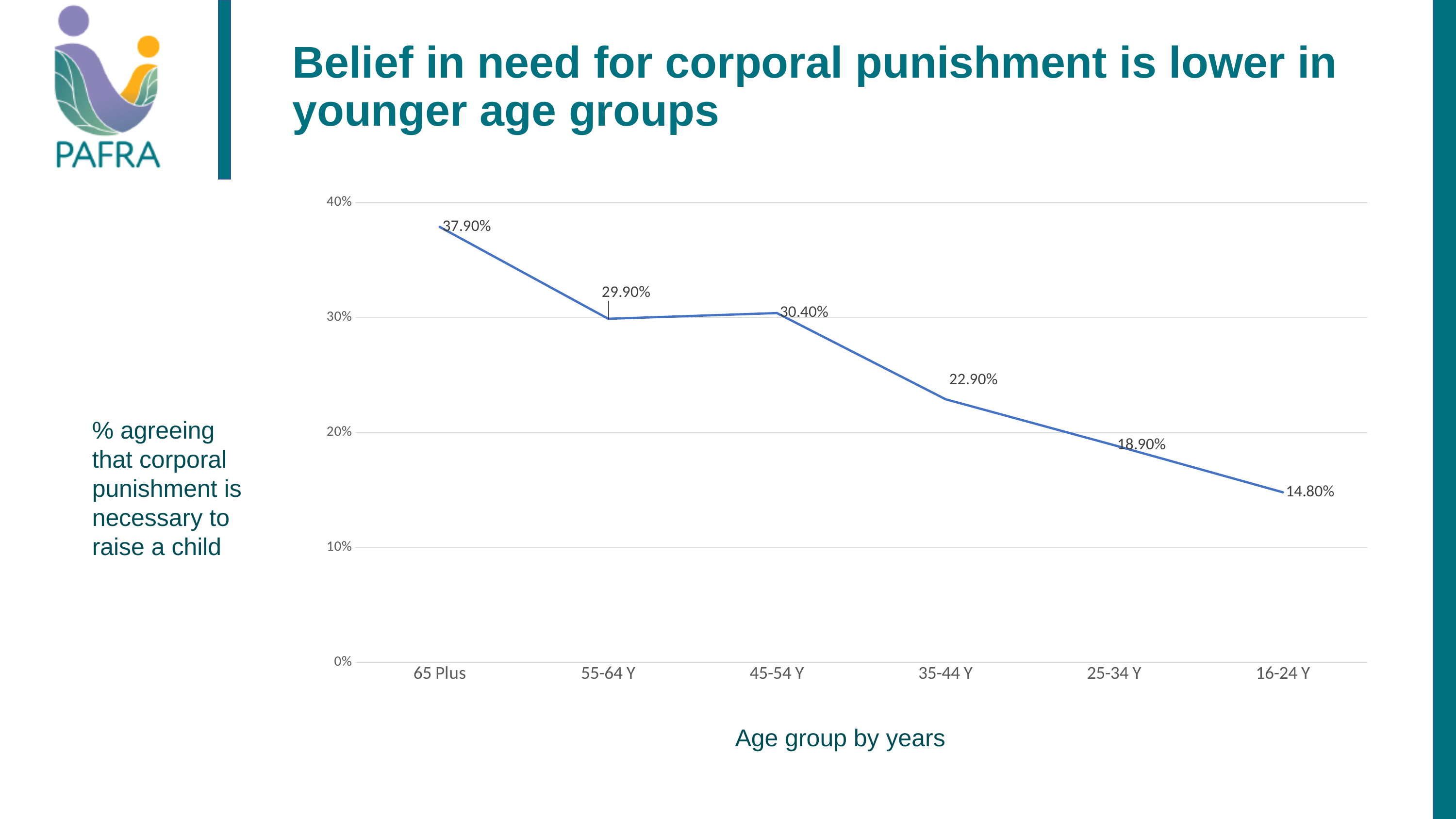
What is the value shown for the 16-24 Y age group? 14.80% How many age groups are plotted on the chart? 6 What percentage of the 65 Plus age group agrees that corporal punishment is necessary to raise a child? 37.90% What is the value shown for the 45-54 Y age group? 30.40% What is the difference between the values for 65 Plus and 16-24 Y? 23.10% Which age group has the highest percentage agreeing that corporal punishment is necessary? 65 Plus What is the label of the x axis? Age group by years What is the value shown for the 35-44 Y age group? 22.90% What kind of chart is shown on the slide? line chart Is the value for 25-34 Y greater or less than 20%? less Which has a larger value, 55-64 Y or 45-54 Y? 45-54 Y Which age group has the lowest percentage agreeing that corporal punishment is necessary? 16-24 Y